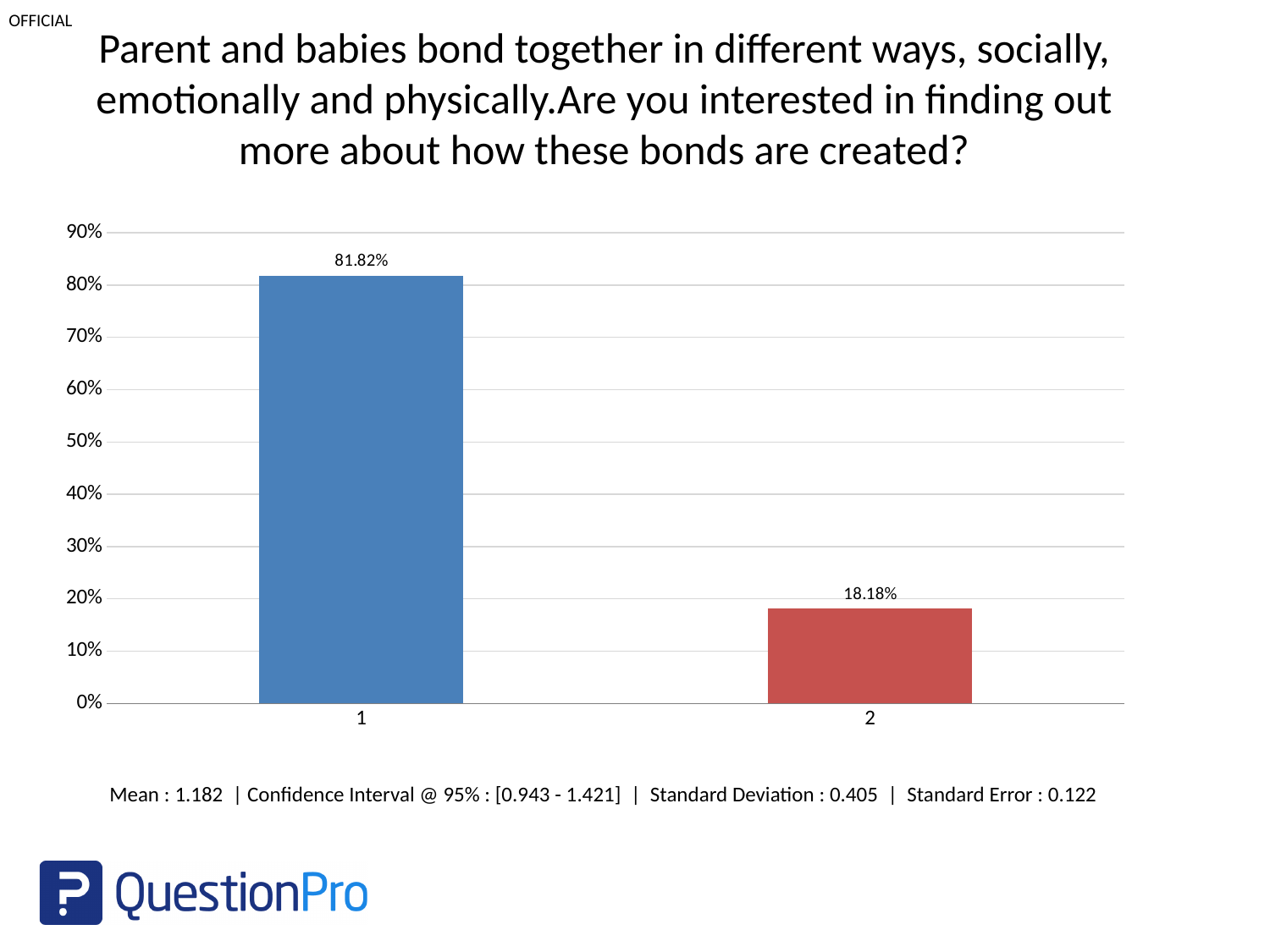
What colour is the bar for category 2? red Which category has the lowest value? 2 What kind of chart is shown on the slide? bar chart Which category has the highest value? 1 What is the value for category 1? 81.82% What is the value for category 2? 18.18% What is the difference between the values for category 1 and category 2? 63.64% Is the value for category 2 greater or less than 20%? less Which is larger, the value for category 1 or category 2? 1 What is the total of the two bar values? 100% How many categories are shown on the x axis? 2 Is the value for category 1 greater or less than 80%? greater